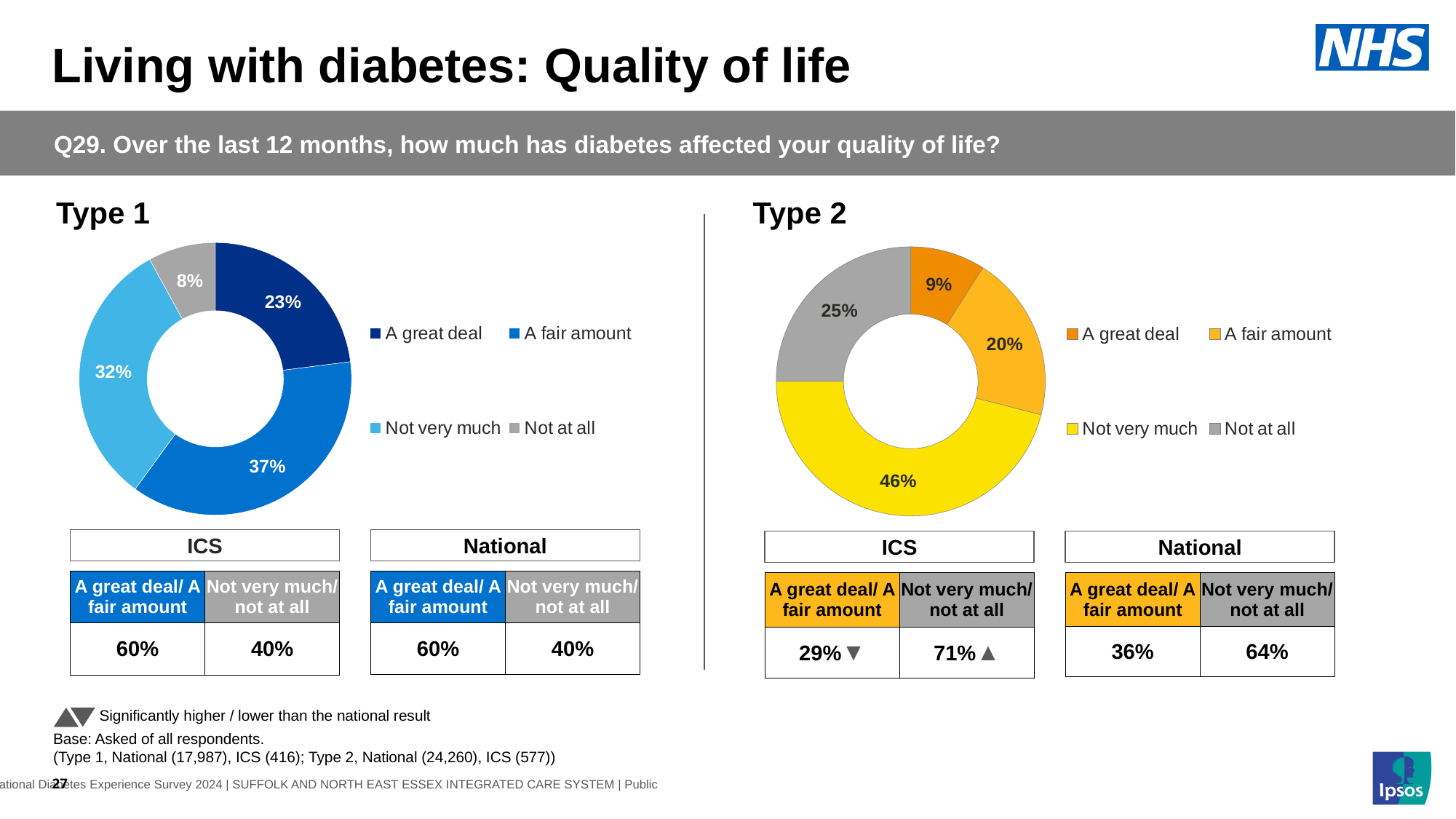
In the Type 1 chart, which response category has the largest share? A fair amount In the Type 1 chart, what percentage said 'Not at all'? 8% In the Type 2 chart, what percentage of respondents said 'Not very much'? 46% In the Type 1 chart, what percentage of respondents said diabetes affected their quality of life 'A fair amount'? 37% In the Type 1 chart, what is the difference in percentage points between 'A fair amount' and 'A great deal'? 14 In the Type 1 chart, what colour represents 'Not very much'? Light blue In the Type 2 chart, what percentage said 'A great deal'? 9% In the Type 2 chart, which response category has the smallest share? A great deal In the Type 2 chart, what is the combined share of 'A great deal' and 'A fair amount'? 29% In the Type 2 chart, which is larger: 'Not at all' or 'A fair amount'? Not at all What kind of chart is used for Type 2? Doughnut (pie) chart How many response categories does the Type 1 chart show? 4